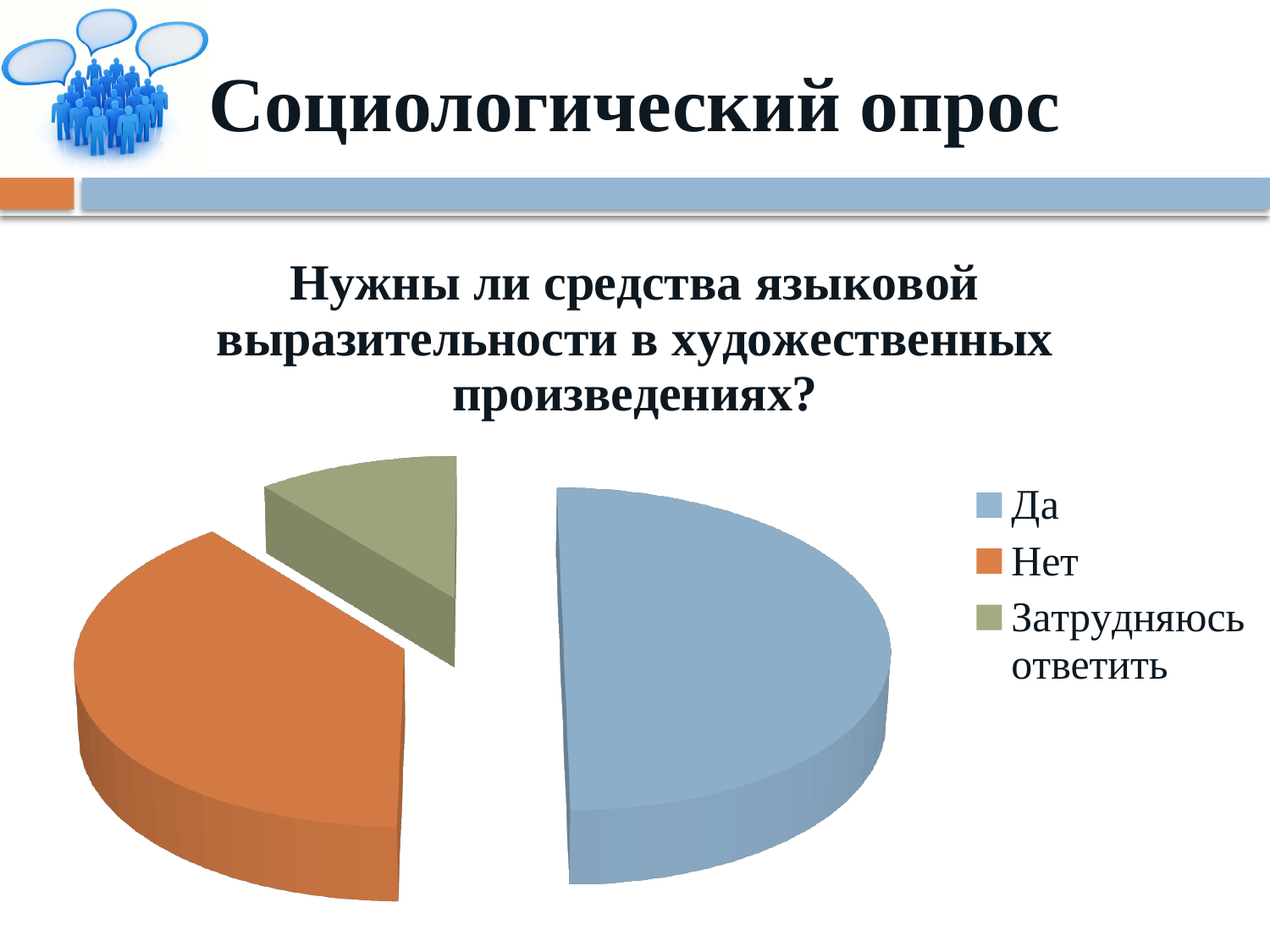
How many entries does the legend of the pie chart list? 3 Which slice is larger in the pie chart, "Да" or "Нет"? Да How many slices does the pie chart have? 3 Which slice is larger in the pie chart, "Нет" or "Затрудняюсь ответить"? Нет Which answer option has the largest slice in the pie chart? Да What kind of chart is shown on the slide? Pie chart What is the title of the pie chart? Нужны ли средства языковой выразительности в художественных произведениях? Which answer option has the smallest slice in the pie chart? Затрудняюсь ответить What colour is the "Нет" slice in the pie chart? Orange